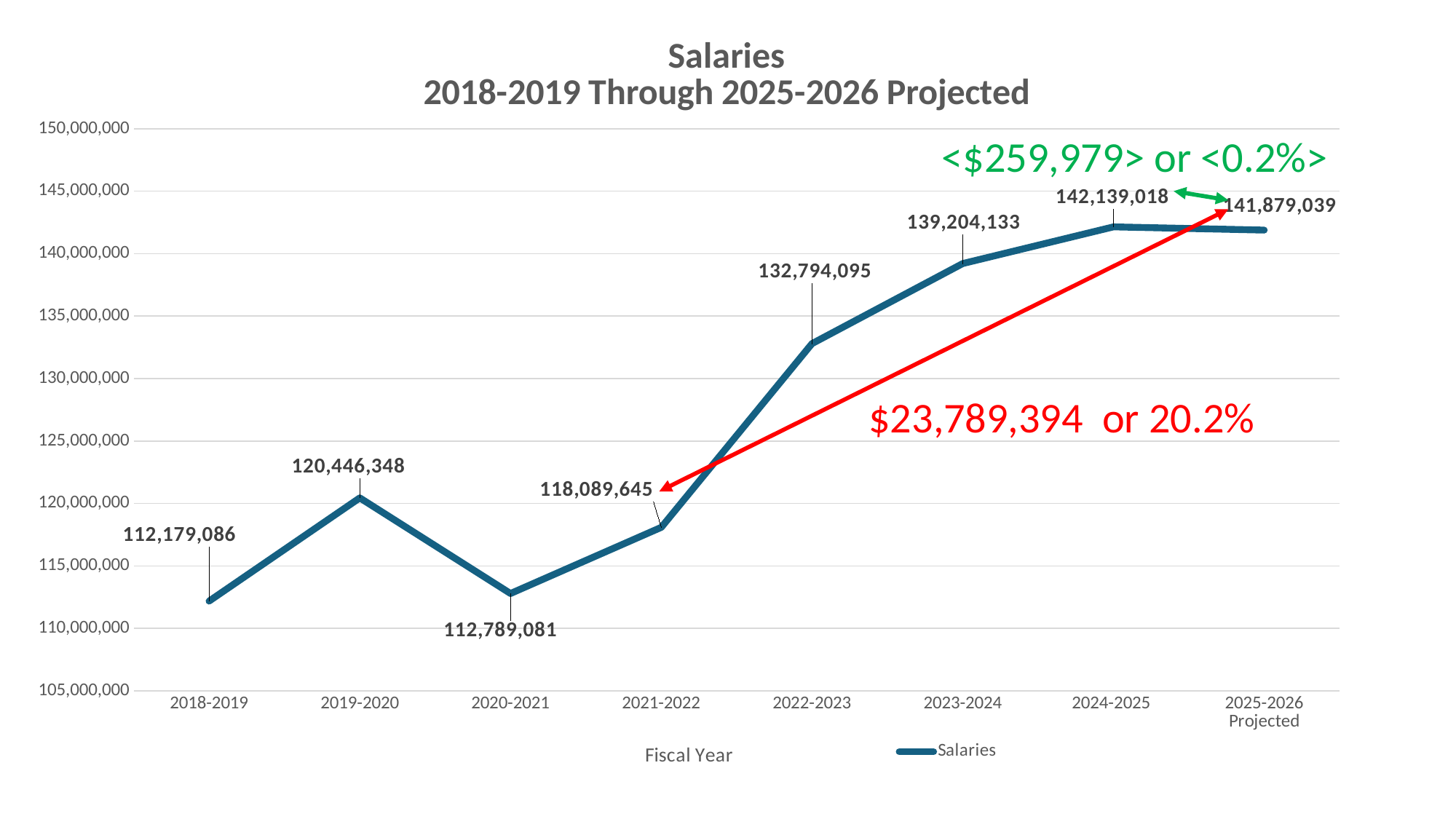
Which is larger, the salaries value for 2019-2020 or for 2021-2022? 2019-2020 How many series does the legend list? 1 How many fiscal years are plotted on the chart? 8 What is the salaries value for fiscal year 2018-2019? 112,179,086 Which fiscal year has the highest salaries value? 2024-2025 What is the projected salaries value for 2025-2026? 141,879,039 Do the salaries values rise or fall from 2021-2022 to 2024-2025? Rise What is the difference between the salaries value for 2024-2025 and the projected value for 2025-2026? 259,979 Which fiscal year has the lowest salaries value? 2018-2019 What kind of chart is shown on the slide? Line chart What is the salaries value for fiscal year 2022-2023? 132,794,095 What is the difference between the salaries values for 2019-2020 and 2018-2019? 8,267,262